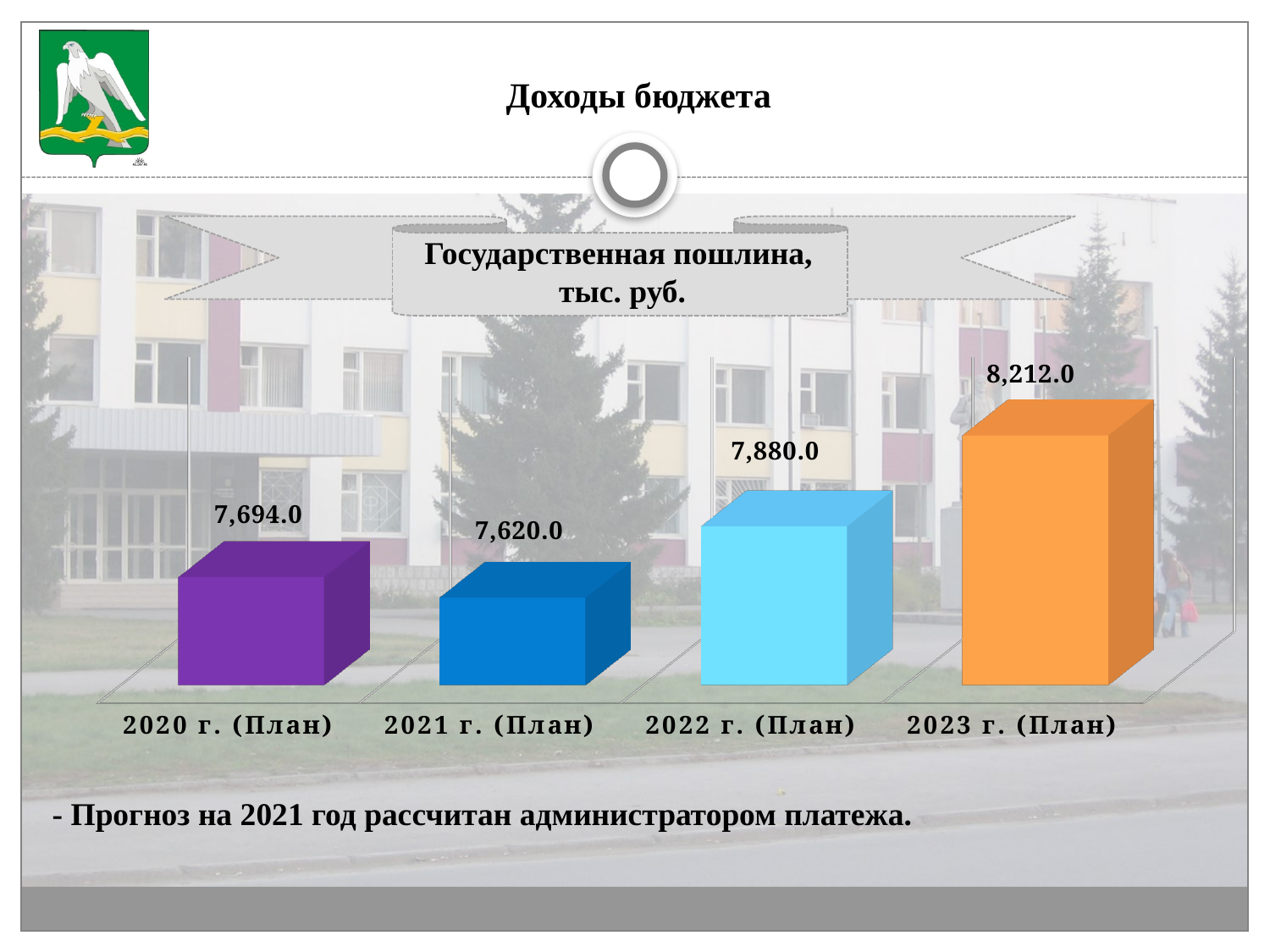
How many categories are shown in the chart? 4 What is the title of the chart? Государственная пошлина, тыс. руб. Which is larger, the value for 2022 г. (План) or the value for 2020 г. (План)? 2022 г. (План) What kind of chart is shown on the slide? bar chart Which category has the highest value? 2023 г. (План) What is the difference between the values for 2023 г. (План) and 2022 г. (План)? 332.0 What is the value for 2023 г. (План)? 8,212.0 What is the value for 2021 г. (План)? 7,620.0 Which category has the lowest value? 2021 г. (План) What is the difference between the values for 2020 г. (План) and 2021 г. (План)? 74.0 What is the value for 2020 г. (План)? 7,694.0 What is the value for 2022 г. (План)? 7,880.0